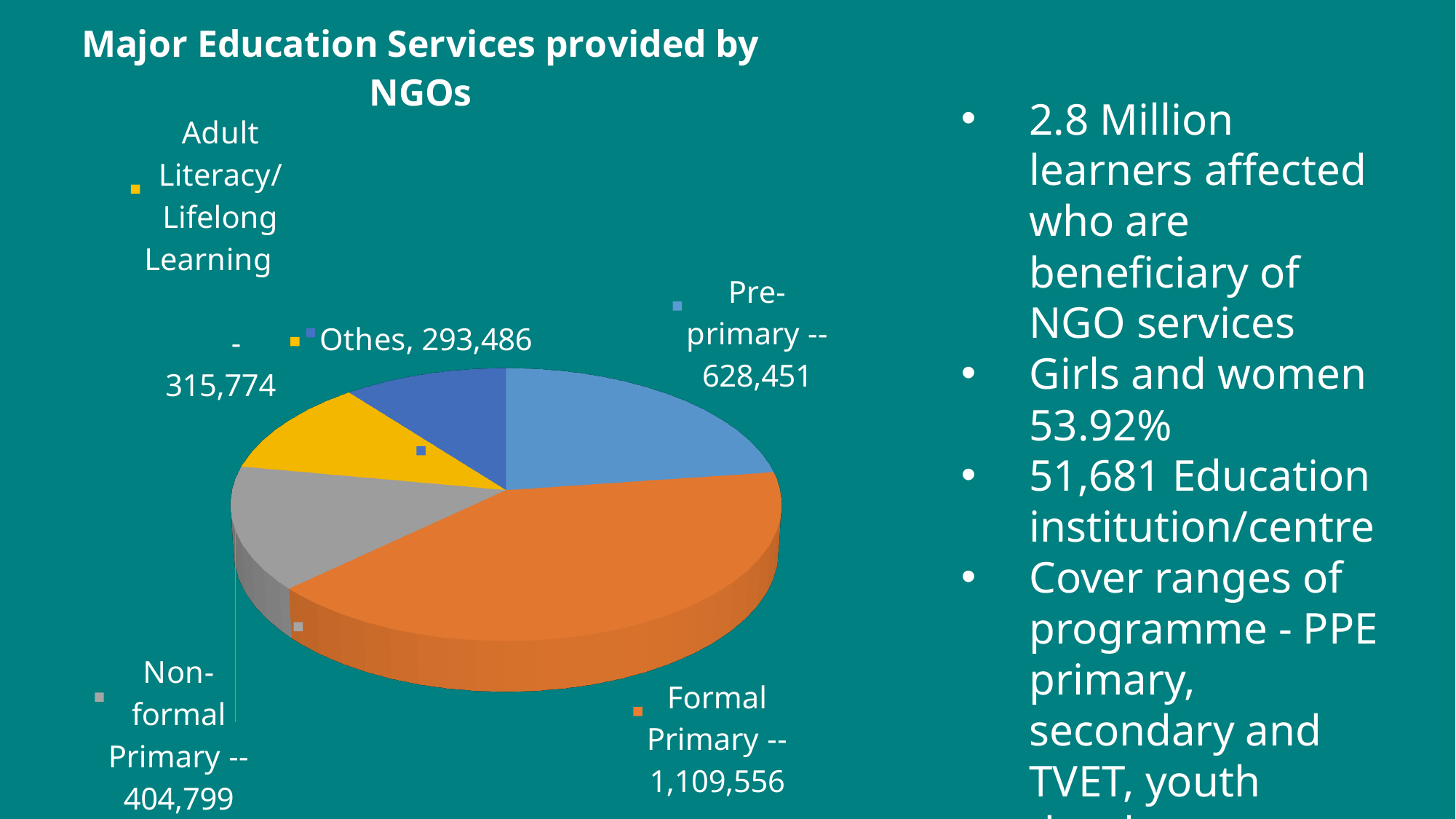
What is the value for Othes? 293,486 What type of chart is shown on the slide? Pie chart What is the value for Non-formal Primary? 404,799 What is the value for Adult Literacy/Lifelong Learning? 315,774 Which is larger, Non-formal Primary or Adult Literacy/Lifelong Learning? Non-formal Primary What is the value for Formal Primary? 1,109,556 Which category has the smallest value? Othes Which category has the largest slice of the pie? Formal Primary What is the value for Pre-primary? 628,451 How many slices does the pie chart have? 5 What is the difference between the Formal Primary and Pre-primary values? 481,105 What is the title of the chart? Major Education Services provided by NGOs